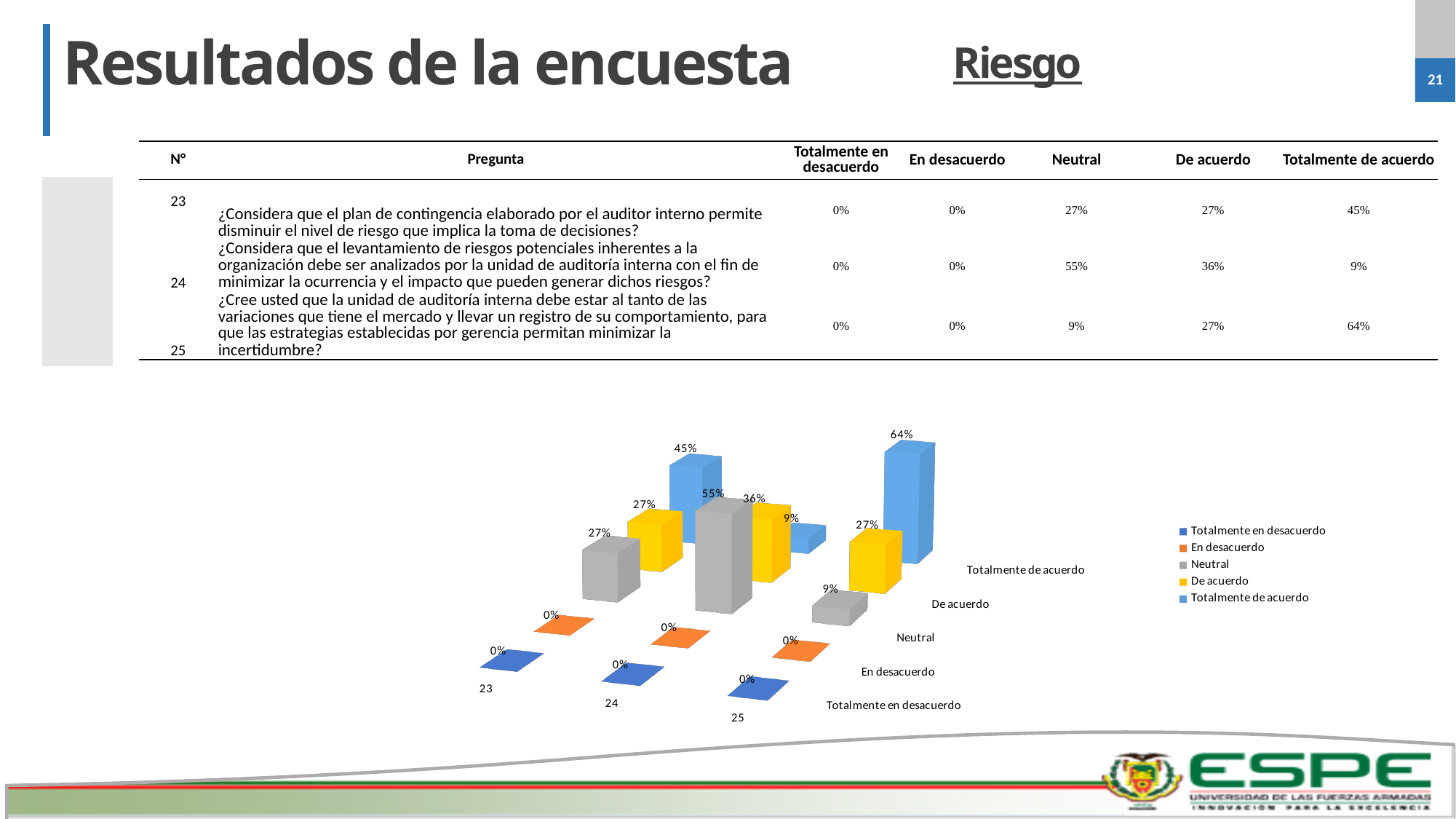
What is the difference between the 'Totalmente de acuerdo' values for question 25 and question 24? 55% What type of chart is shown on the slide? bar chart How many series does the chart legend list? 5 Which question has the highest 'Totalmente de acuerdo' value in the chart? 25 How many question categories are plotted along the x axis of the chart? 3 What is the value of 'Totalmente de acuerdo' for question 23 in the chart? 45% Which is larger in the chart: 'Neutral' for question 24 or 'Neutral' for question 23? Neutral for question 24 Which colour represents the 'De acuerdo' series in the chart? yellow What is the value of 'De acuerdo' for question 24 in the chart? 36% What is the value of 'Neutral' for question 24 in the chart? 55% Which question has the lowest 'Neutral' value in the chart? 25 What is the value of 'Totalmente de acuerdo' for question 25 in the chart? 64%